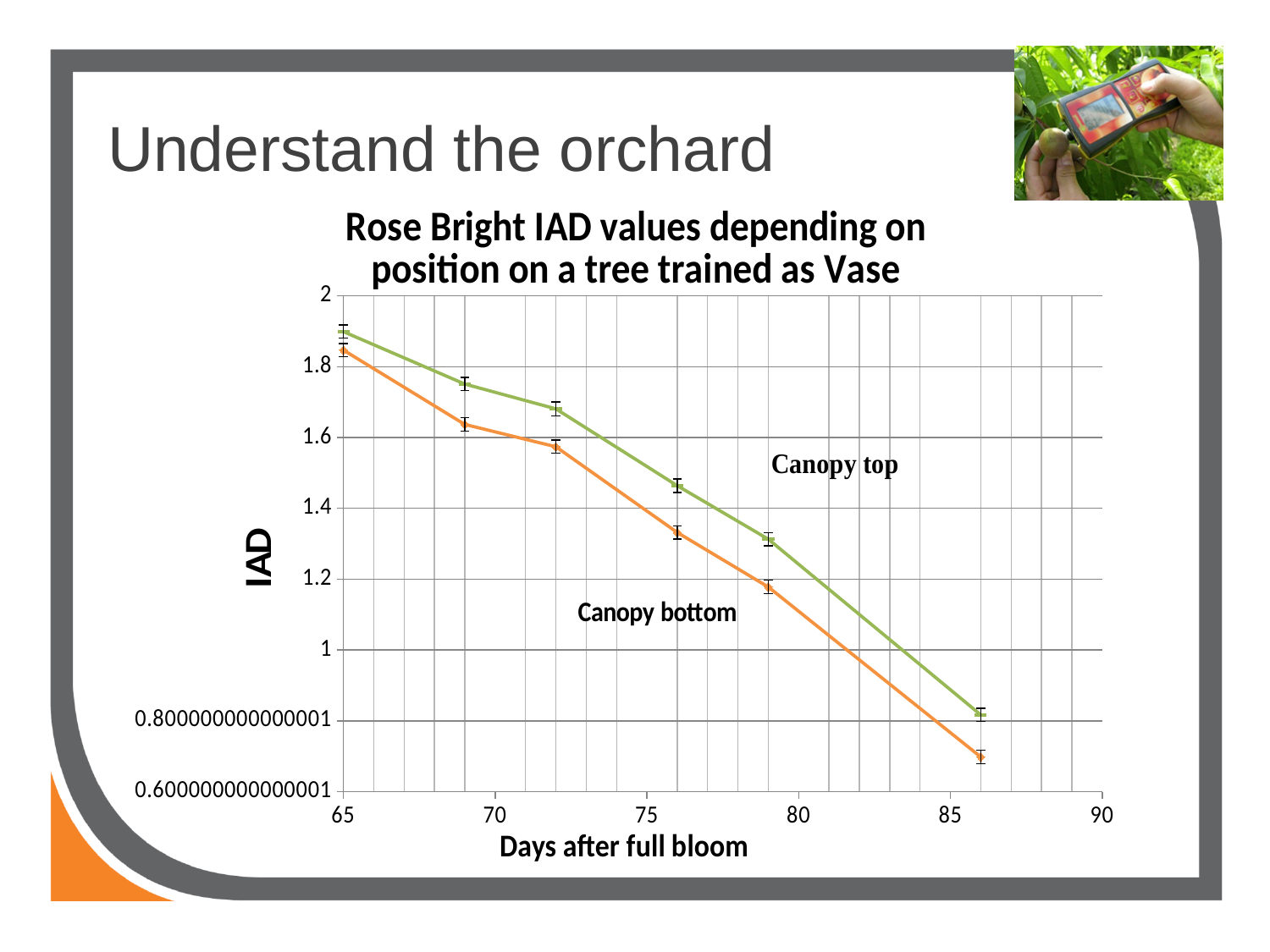
What is the title of the chart? Rose Bright IAD values depending on position on a tree trained as Vase At which day after full bloom is the Canopy top IAD value lowest? 86 At which day after full bloom is the Canopy bottom IAD value highest? 65 How many series are plotted on the chart? 2 Do the IAD values rise or fall as days after full bloom increase? fall How many data points does the Canopy top series have? 6 Is the Canopy bottom IAD value at 76 days after full bloom greater or less than 1.4? less Which series has the higher IAD value at 72 days after full bloom, Canopy top or Canopy bottom? Canopy top What is the label of the x axis? Days after full bloom Is the Canopy bottom IAD value at 86 days after full bloom greater or less than 0.8? less What kind of chart is shown on the slide? line chart Is the Canopy top IAD value at 65 days after full bloom greater or less than 1.8? greater